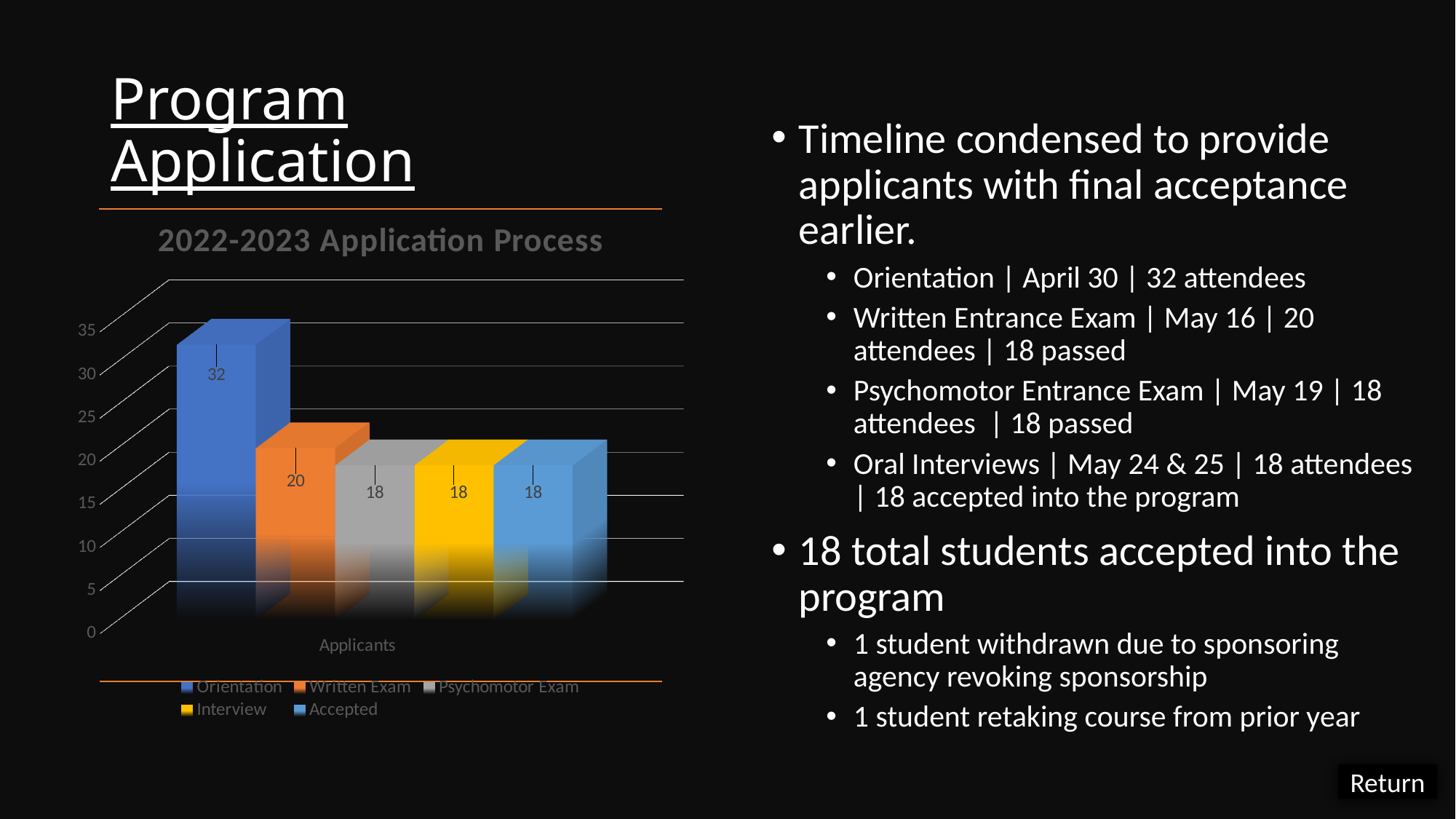
Which is larger in the 2022-2023 Application Process chart, Orientation or Written Exam? Orientation What is the title of the chart on the slide? 2022-2023 Application Process Is the value for Orientation greater or less than 30 in the 2022-2023 Application Process chart? greater What is the value for Psychomotor Exam in the 2022-2023 Application Process chart? 18 What kind of chart is the 2022-2023 Application Process chart? Bar chart What is the value for Written Exam in the 2022-2023 Application Process chart? 20 What is the difference between the Written Exam and Interview values in the 2022-2023 Application Process chart? 2 What is the difference between the Orientation and Written Exam values in the 2022-2023 Application Process chart? 12 Which series has the highest value in the 2022-2023 Application Process chart? Orientation What is the value for Orientation in the 2022-2023 Application Process chart? 32 What is the value for Accepted in the 2022-2023 Application Process chart? 18 How many series does the legend list in the 2022-2023 Application Process chart? 5